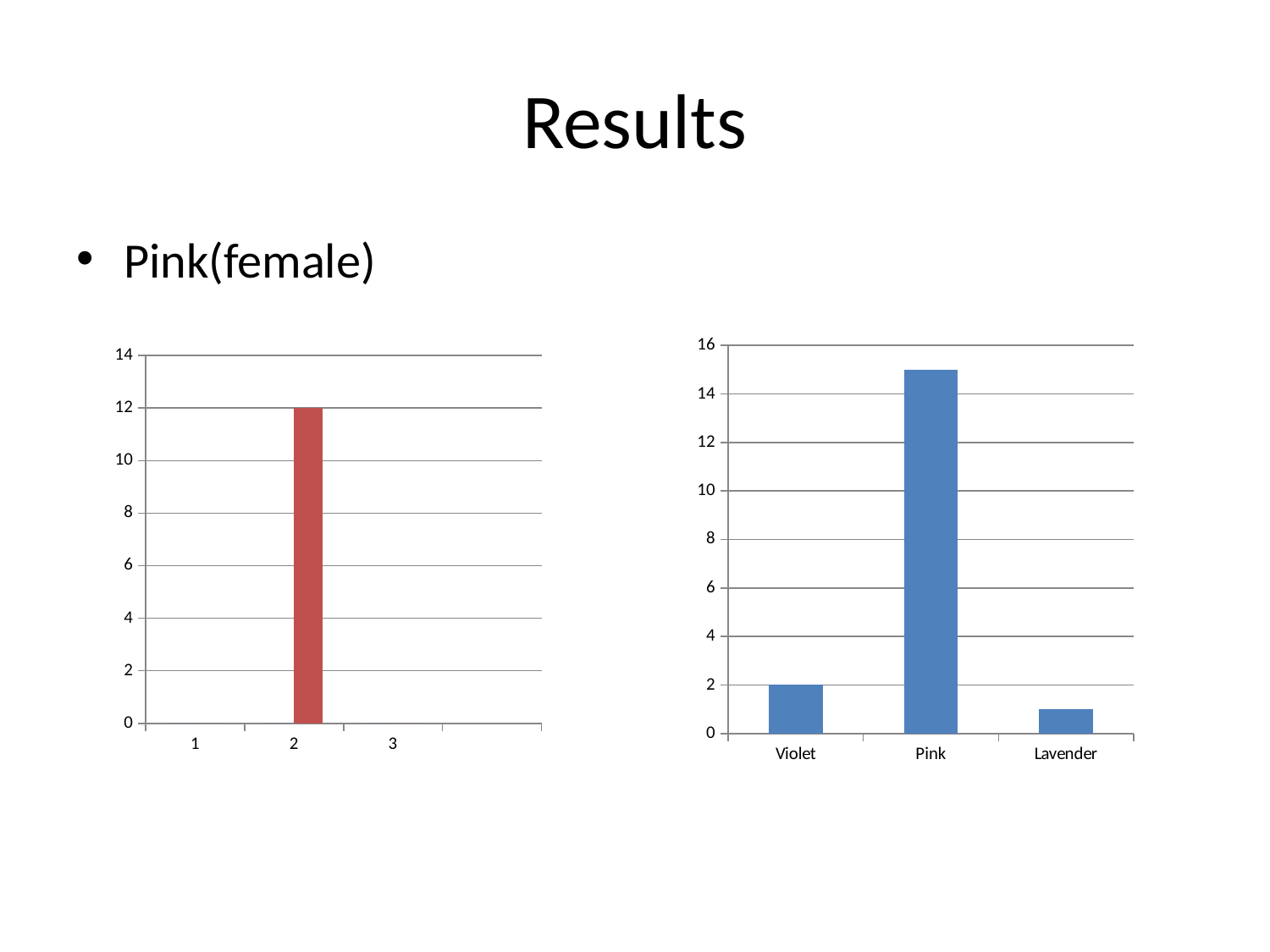
On the right chart, is the value for Pink greater or less than 14? greater On the right chart, is the value for Lavender greater or less than 2? less What colour is the bar on the left chart? red How many categories are shown on the x axis of the right chart? 3 On the left chart, is the value for category 2 greater or less than 10? greater On the right chart, which is larger, the value for Violet or the value for Lavender? Violet On the right chart, what is the value for Violet? 2 On the right chart, which category has the lowest value? Lavender On the left chart, what is the value for category 2? 12 What kind of chart is the right chart? bar chart How many categories are labelled on the x axis of the left chart? 3 On the right chart, which category has the highest value? Pink